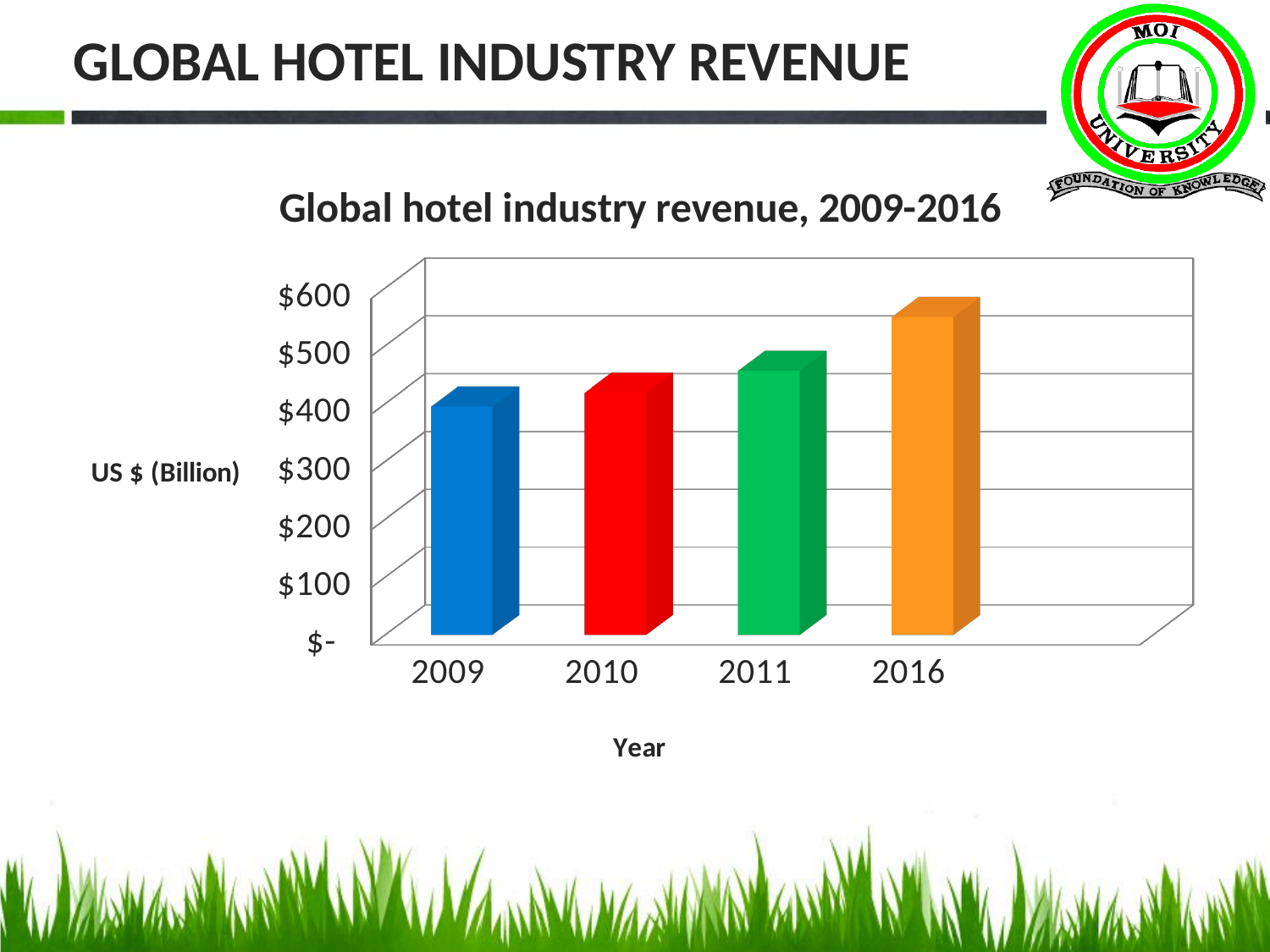
What kind of chart is shown on the slide? Bar chart Is the revenue for 2016 greater or less than $500? greater Which year has the lowest global hotel industry revenue? 2009 Is the revenue for 2009 greater or less than $300? greater Is the revenue for 2010 greater or less than $500? less Which year has the larger revenue, 2009 or 2016? 2016 Which year has the highest global hotel industry revenue? 2016 What is the title of the chart? Global hotel industry revenue, 2009-2016 Do the revenue values rise or fall from 2009 to 2016? Rise How many years are plotted on the chart? 4 What is the label on the vertical axis of the chart? US $ (Billion)